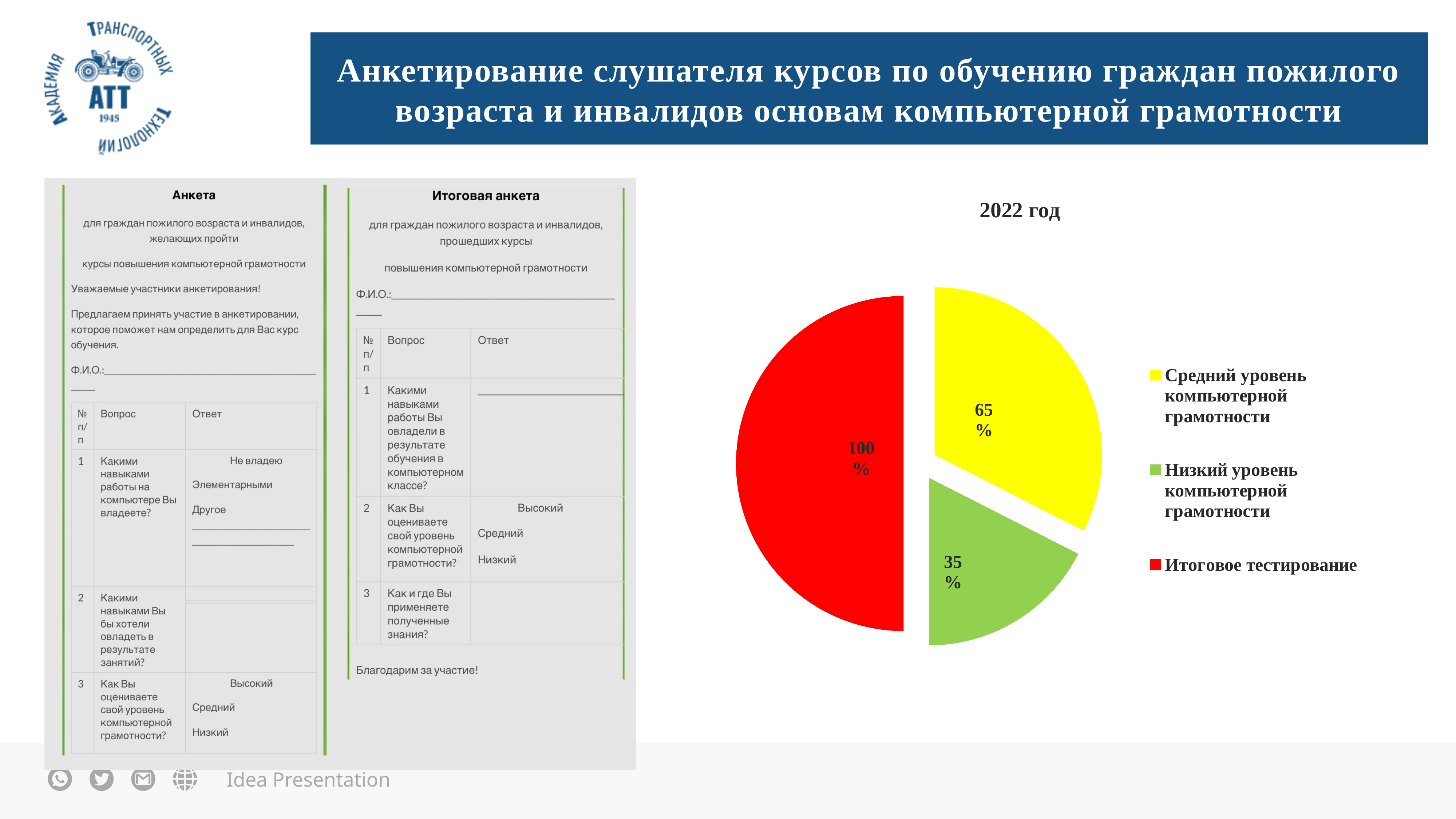
What value is labelled on the slice for Низкий уровень компьютерной грамотности? 35% What colour is the slice for Итоговое тестирование? red What value is labelled on the slice for Средний уровень компьютерной грамотности? 65% How many slices does the pie chart have? 3 How many entries does the chart legend list? 3 What is the title of the chart? 2022 год What kind of chart is shown on the slide? pie chart Which slice has the smallest labelled value? Низкий уровень компьютерной грамотности Which slice has the largest labelled value? Итоговое тестирование Which is larger, the value for Средний уровень компьютерной грамотности or the value for Низкий уровень компьютерной грамотности? Средний уровень компьютерной грамотности What value is labelled on the slice for Итоговое тестирование? 100% What is the difference between the labelled values for Средний уровень компьютерной грамотности and Низкий уровень компьютерной грамотности? 30%